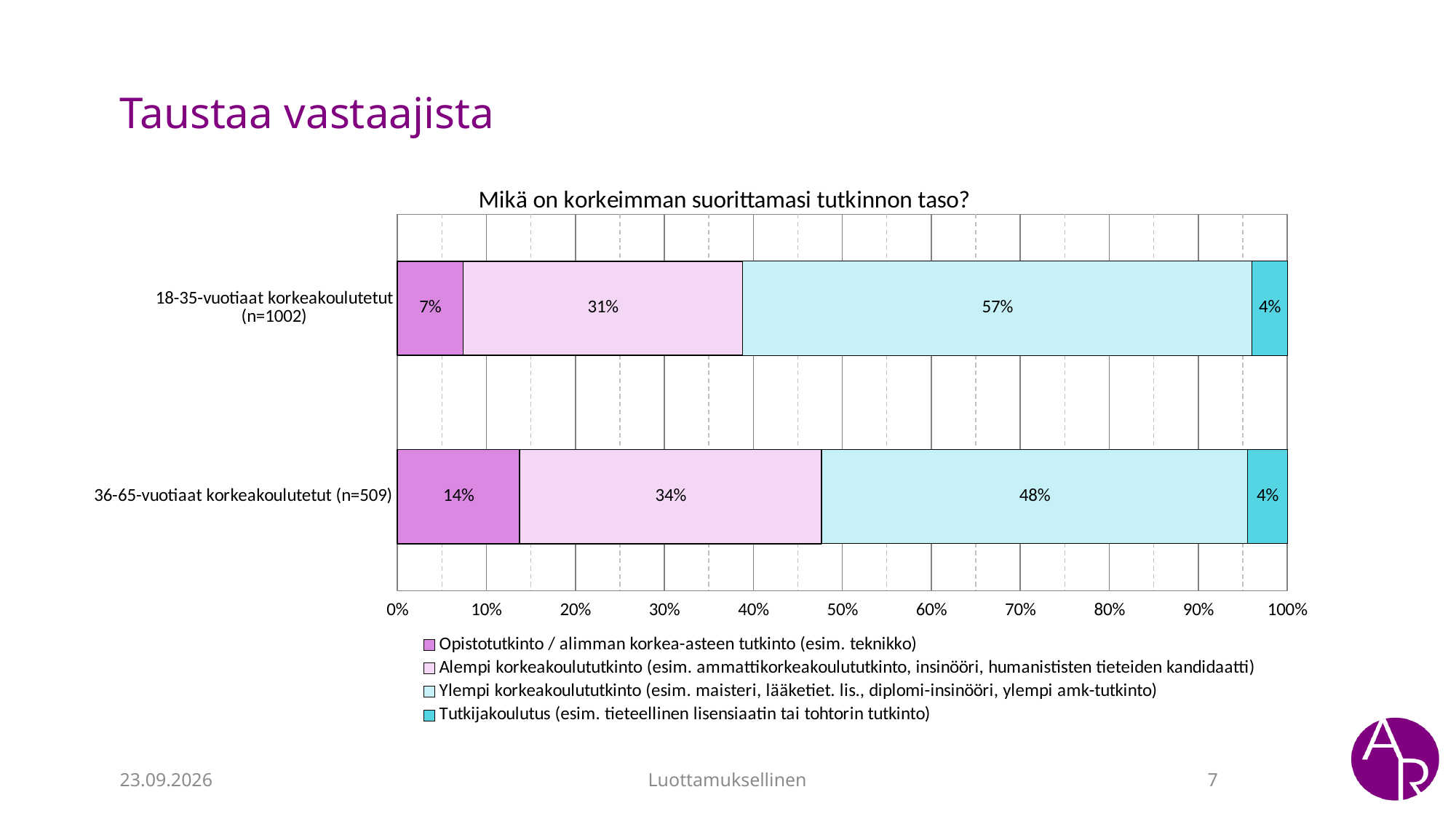
What is the title of the chart? Mikä on korkeimman suorittamasi tutkinnon taso? How many respondent groups are shown on the chart? 2 What is the value for Ylempi korkeakoulututkinto among 18-35-vuotiaat korkeakoulutetut (n=1002)? 57% What is the value for Tutkijakoulutus among 36-65-vuotiaat korkeakoulutetut (n=509)? 4% Which education level has the smallest share among 18-35-vuotiaat korkeakoulutetut (n=1002)? Tutkijakoulutus What is the difference between the Ylempi korkeakoulututkinto shares of the 18-35 group and the 36-65 group? 9 percentage points What is the value for Alempi korkeakoulututkinto among 18-35-vuotiaat korkeakoulutetut (n=1002)? 31% What kind of chart is shown on the slide? Stacked bar chart What is the value for Opistotutkinto / alimman korkea-asteen tutkinto among 36-65-vuotiaat korkeakoulutetut (n=509)? 14% How many series does the legend list? 4 Which group has the larger share of Opistotutkinto / alimman korkea-asteen tutkinto, 18-35-vuotiaat or 36-65-vuotiaat? 36-65-vuotiaat korkeakoulutetut (n=509) Which education level has the largest share among 36-65-vuotiaat korkeakoulutetut (n=509)? Ylempi korkeakoulututkinto